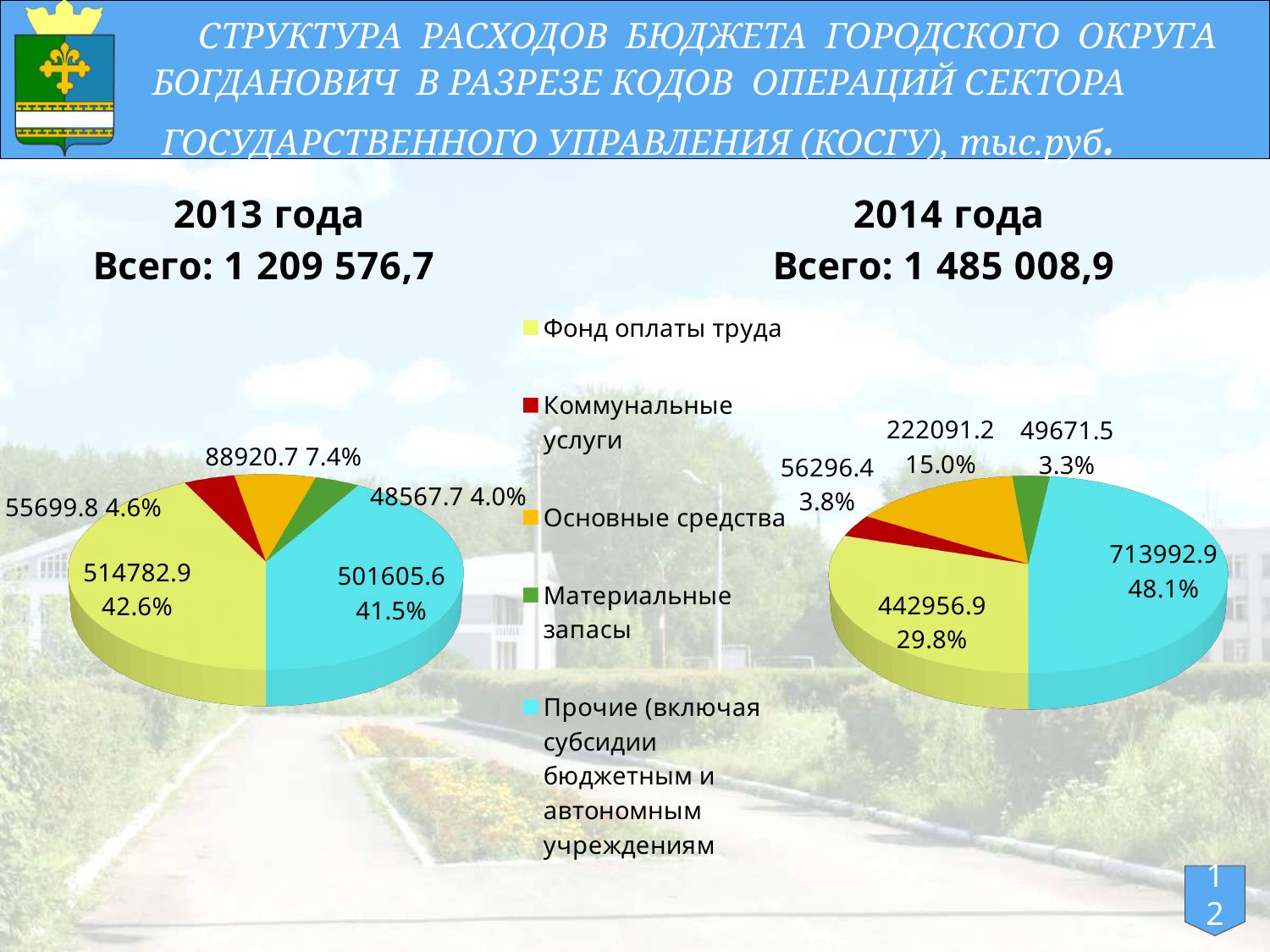
What kind of charts are shown on the slide? Pie charts In the 2013 pie chart, what is the value for Фонд оплаты труда? 514782.9 In the 2014 pie chart, which is larger: Основные средства or Коммунальные услуги? Основные средства How many categories does the legend list? 5 Which colour represents Материальные запасы in the legend? Green In the 2014 pie chart, what share does Основные средства have? 15.0% In the 2013 pie chart, what share does Коммунальные услуги have? 4.6% What total is shown for 2014 года? 1 485 008,9 In the 2014 pie chart, what is the value for Прочие (включая субсидии бюджетным и автономным учреждениям)? 713992.9 In the 2013 pie chart, which category has the largest value? Фонд оплаты труда In the 2013 pie chart, what is the difference between Фонд оплаты труда and Прочие (включая субсидии бюджетным и автономным учреждениям)? 13177.3 In the 2014 pie chart, which category has the smallest value? Материальные запасы